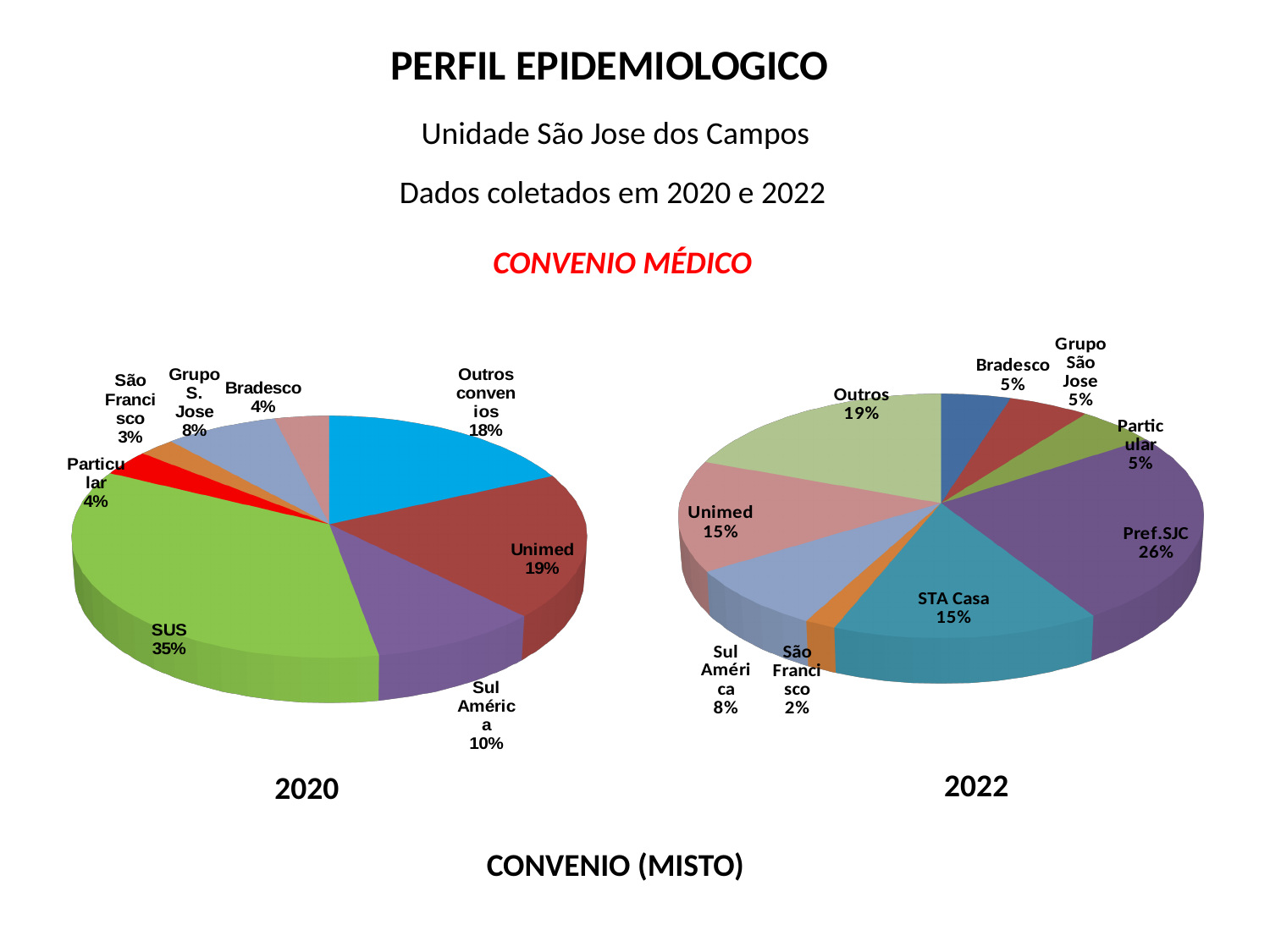
How many slices does the 2020 pie chart have? 8 How many slices does the 2022 pie chart have? 9 In the 2020 pie chart, what share does SUS have? 35% In the 2022 pie chart, what is the difference between the shares of Outros and Unimed? 4% In the 2022 pie chart, what share does Pref.SJC have? 26% In the 2022 pie chart, which category has the smallest share? São Francisco In the 2020 pie chart, which is larger, the share of Unimed or the share of Outros convenios? Unimed What kind of chart is used for the 2020 data? Pie chart What is the red heading shown above the two pie charts? CONVENIO MÉDICO In the 2020 pie chart, which category has the smallest share? São Francisco In the 2022 pie chart, what share does STA Casa have? 15% In the 2020 pie chart, which category has the largest share? SUS